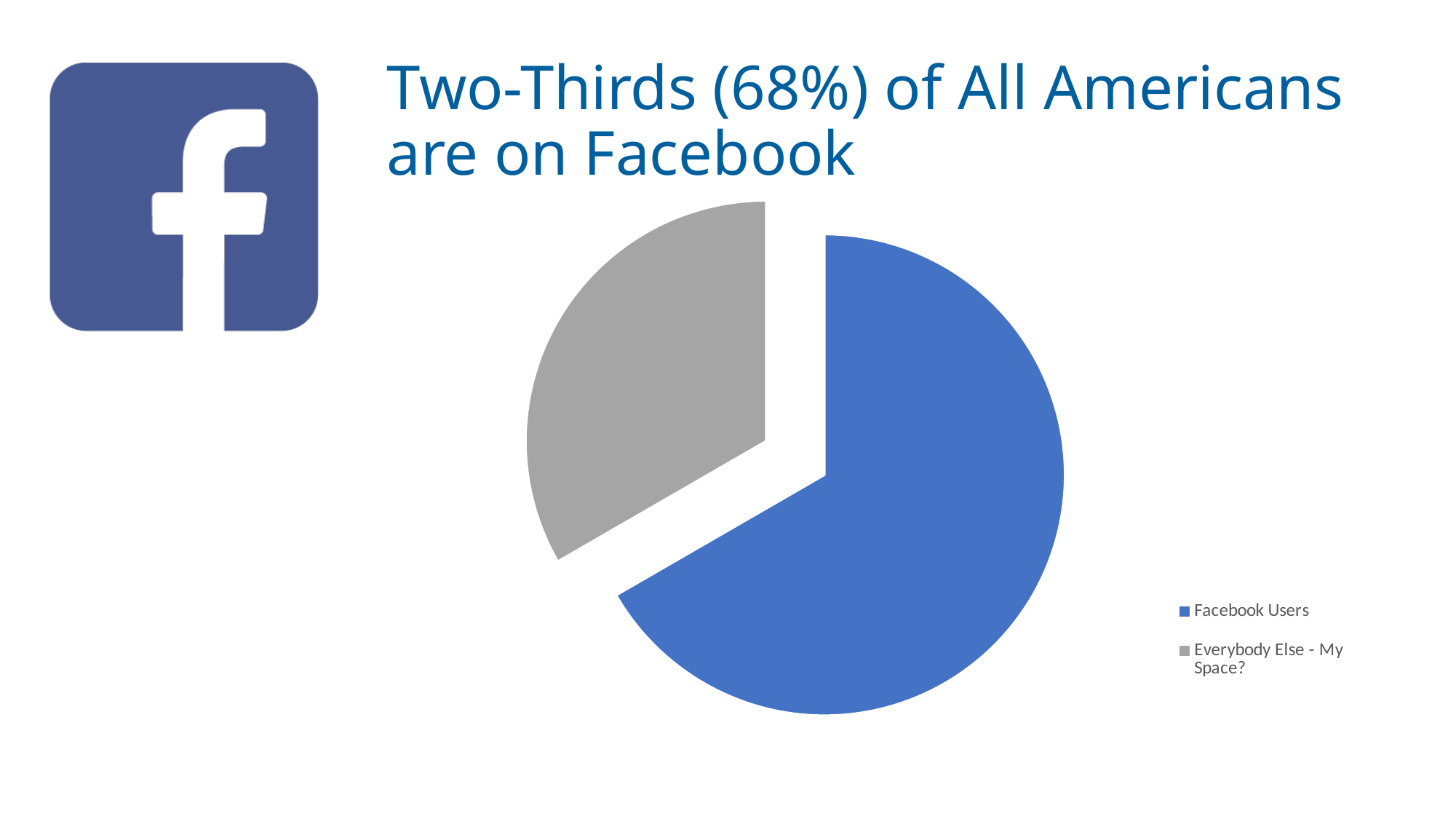
Which slice of the pie chart is the largest? Facebook Users Which slice is larger, Facebook Users or Everybody Else - My Space? Facebook Users According to the slide title, what percentage of all Americans are on Facebook? 68% What kind of chart is shown on the slide? Pie chart Which slice of the pie chart is the smallest? Everybody Else - My Space? How many entries does the legend of the pie chart list? 2 How many slices does the pie chart have? 2 What colour is the Facebook Users slice in the pie chart? Blue